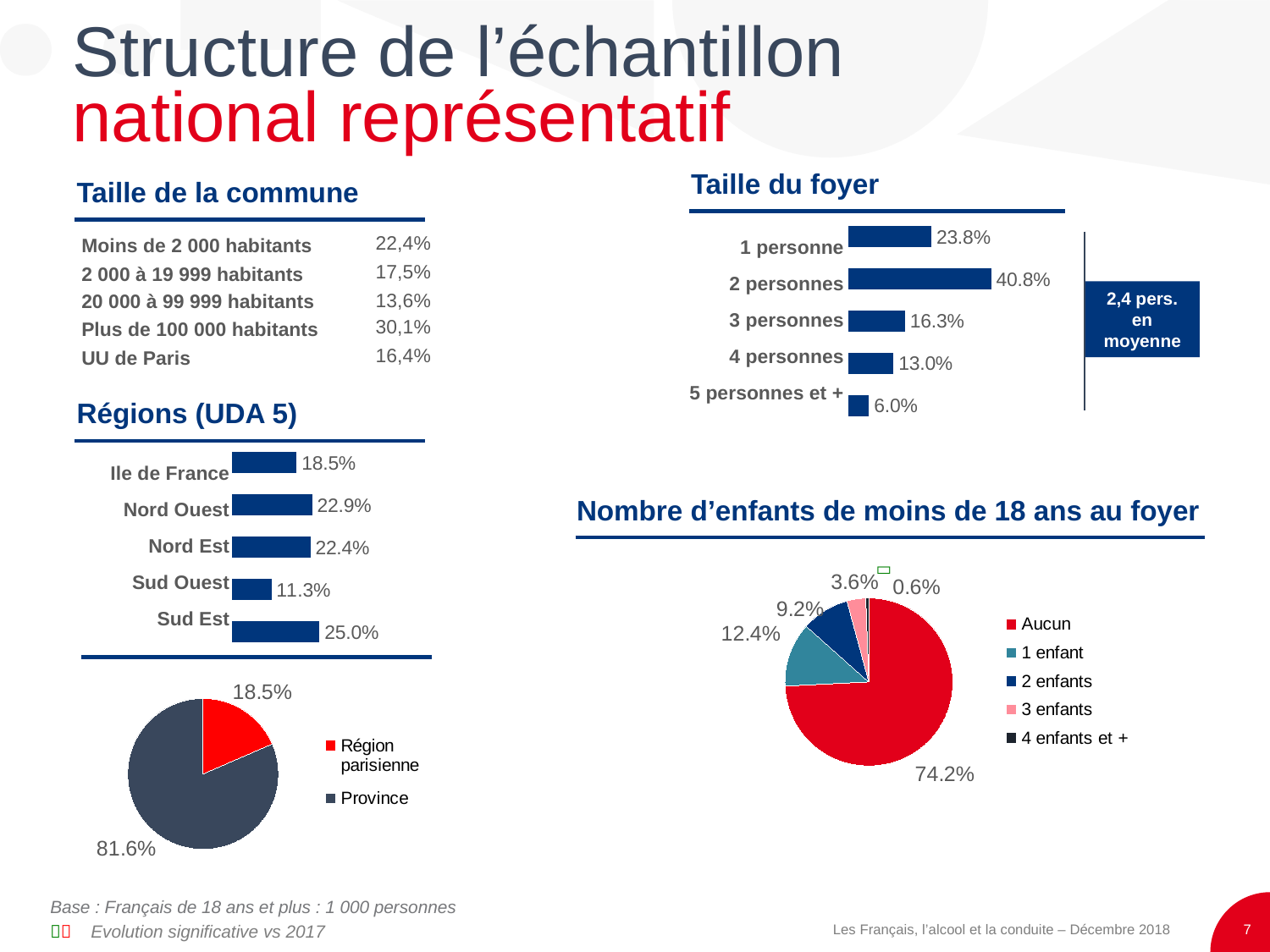
In the 'Taille du foyer' chart, which household size has the lowest value? 5 personnes et + How many categories are shown in the 'Taille du foyer' chart? 5 In the 'Nombre d'enfants de moins de 18 ans au foyer' pie chart, what is the value for '1 enfant'? 12.4% What kind of chart is the 'Régions (UDA 5)' chart? Bar chart How many series does the legend of the 'Nombre d'enfants de moins de 18 ans au foyer' pie chart list? 5 In the 'Taille du foyer' chart, what is the value for '2 personnes'? 40.8% In the pie chart below the 'Régions (UDA 5)' chart, what share is 'Province'? 81.6% In the 'Régions (UDA 5)' chart, which region has the highest value? Sud Est In the 'Taille du foyer' chart, what is the difference between the values for '1 personne' and '4 personnes'? 10.8% In the 'Régions (UDA 5)' chart, which is larger: 'Ile de France' or 'Nord Ouest'? Nord Ouest In the 'Nombre d'enfants de moins de 18 ans au foyer' pie chart, which category has the smallest slice? 4 enfants et + In the 'Régions (UDA 5)' chart, what is the value for 'Sud Ouest'? 11.3%